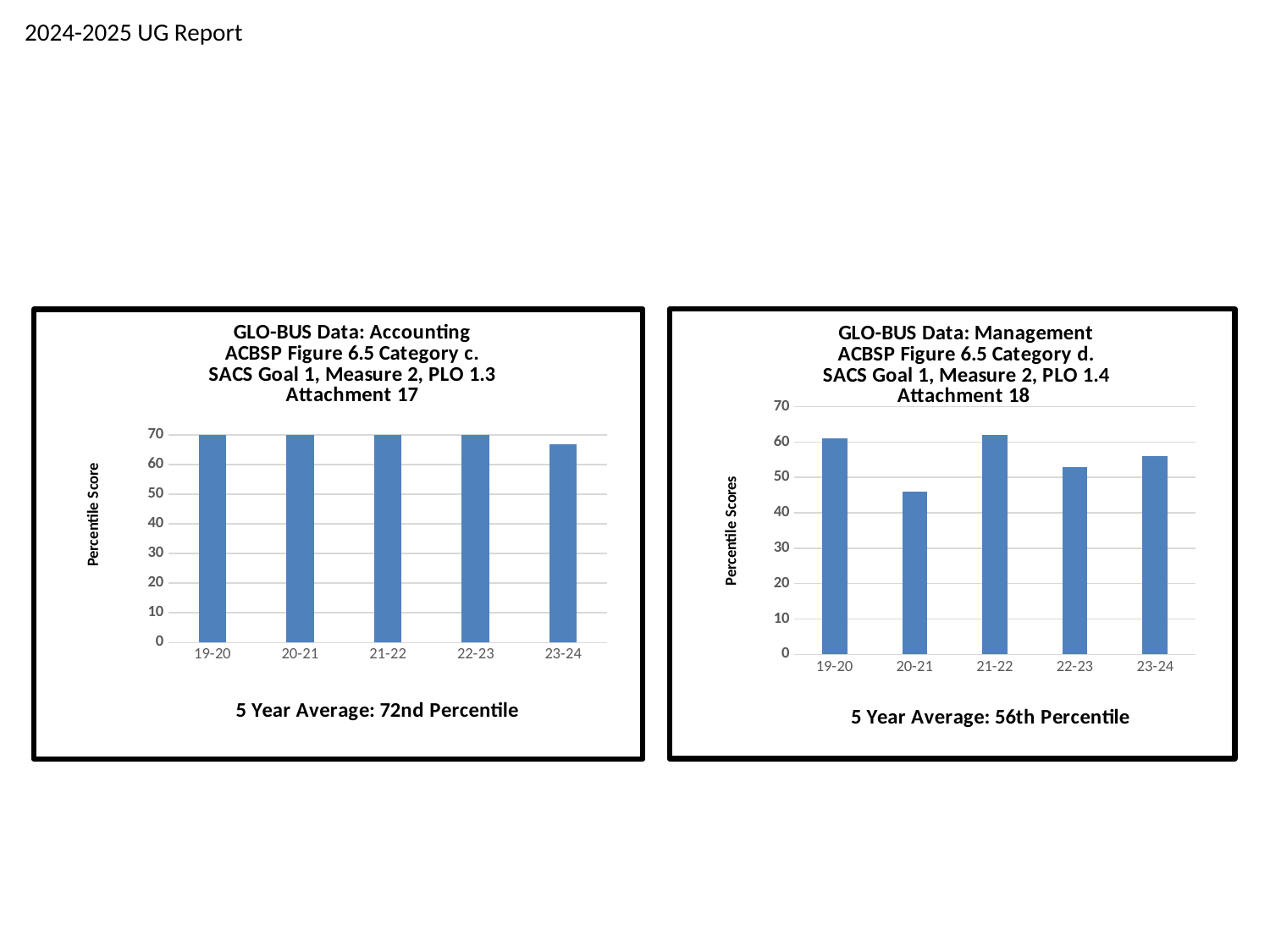
In the GLO-BUS Data: Management chart, is the value for 20-21 greater or less than 50? less What kind of chart is the GLO-BUS Data: Accounting chart? bar chart How many bars are in the GLO-BUS Data: Management chart? 5 What 5 year average is stated below the GLO-BUS Data: Accounting chart? 72nd Percentile In the GLO-BUS Data: Management chart, which year has the lowest percentile score? 20-21 What is the y-axis label of the GLO-BUS Data: Management chart? Percentile Scores In the GLO-BUS Data: Management chart, is the value for 19-20 greater or less than 50? greater In the GLO-BUS Data: Management chart, which is larger, the value for 20-21 or the value for 22-23? 22-23 In the GLO-BUS Data: Accounting chart, which year has the lowest percentile score? 23-24 In the GLO-BUS Data: Accounting chart, is the value for 23-24 greater or less than 60? greater In the GLO-BUS Data: Accounting chart, what is the percentile score for 19-20? 70 How many years are shown on the x axis of the GLO-BUS Data: Accounting chart? 5